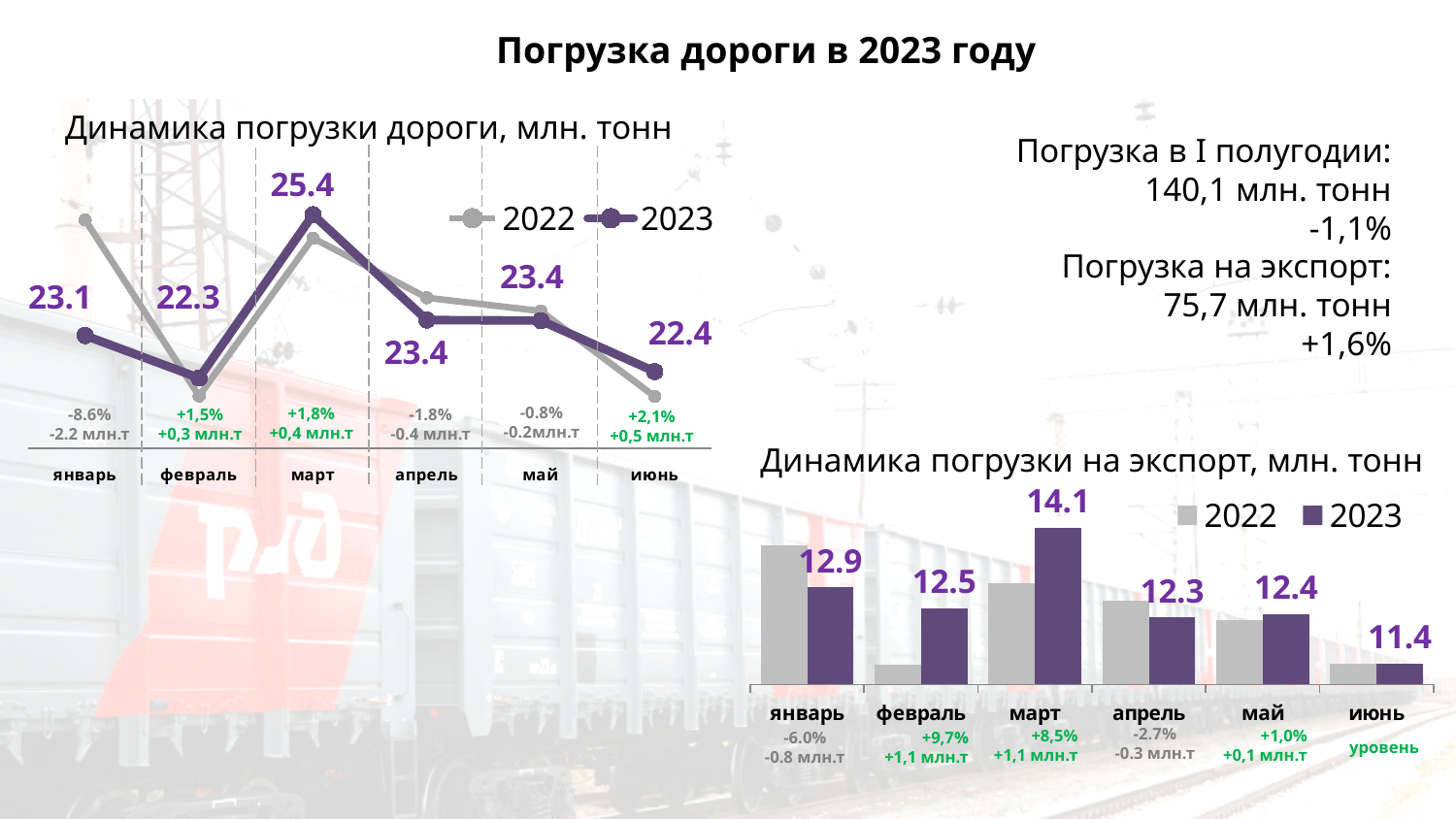
In the chart 'Динамика погрузки на экспорт, млн. тонн', which month has the lowest 2023 value? июнь In the chart 'Динамика погрузки дороги, млн. тонн', what is the 2023 value for январь? 23.1 What kind of chart is 'Динамика погрузки дороги, млн. тонн'? line chart In the chart 'Динамика погрузки на экспорт, млн. тонн', which is larger for февраль: the 2022 bar or the 2023 bar? 2023 In the chart 'Динамика погрузки на экспорт, млн. тонн', how many months are shown on the x axis? 6 What kind of chart is 'Динамика погрузки на экспорт, млн. тонн'? bar chart In the chart 'Динамика погрузки на экспорт, млн. тонн', what is the 2023 value for март? 14.1 In the chart 'Динамика погрузки дороги, млн. тонн', what is the 2023 value for март? 25.4 In the chart 'Динамика погрузки дороги, млн. тонн', how many series does the legend list? 2 In the chart 'Динамика погрузки дороги, млн. тонн', which month has the lowest 2023 value? февраль In the chart 'Динамика погрузки дороги, млн. тонн', what is the difference between the 2023 values for март and июнь? 3.0 In the chart 'Динамика погрузки дороги, млн. тонн', which month has the highest 2023 value? март